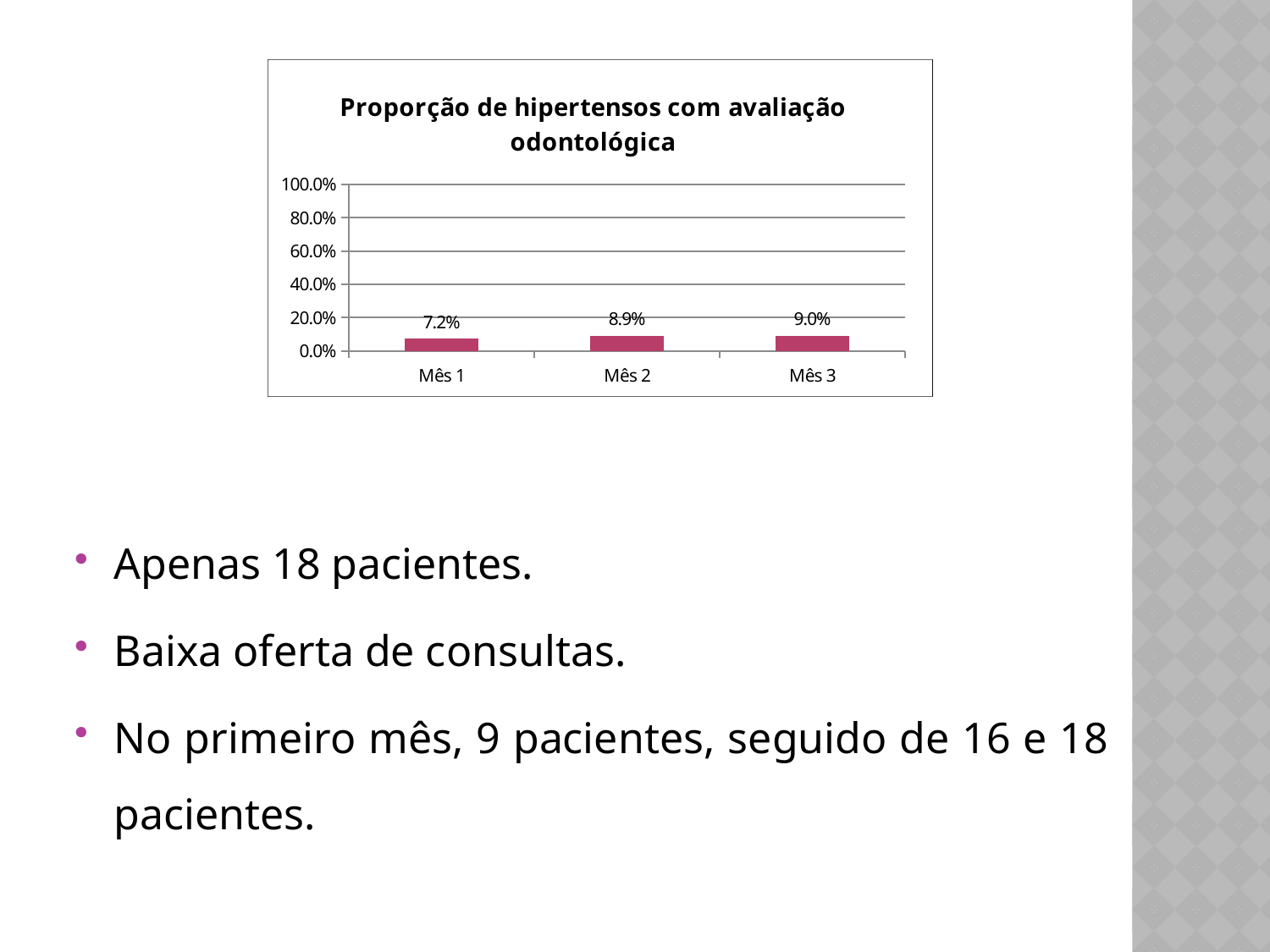
Which is larger, the value for Mês 1 or the value for Mês 2? Mês 2 How many months are shown on the x axis? 3 Which month has the lowest value? Mês 1 What is the difference between the values for Mês 3 and Mês 1? 1.8% Which month has the highest value? Mês 3 What kind of chart is shown? bar chart What is the difference between the values for Mês 2 and Mês 1? 1.7% What is the value for Mês 2? 8.9% Is the value for Mês 3 greater or less than 20.0%? less What is the value for Mês 3? 9.0% Do the values rise or fall from Mês 1 to Mês 3? rise What is the value for Mês 1? 7.2%